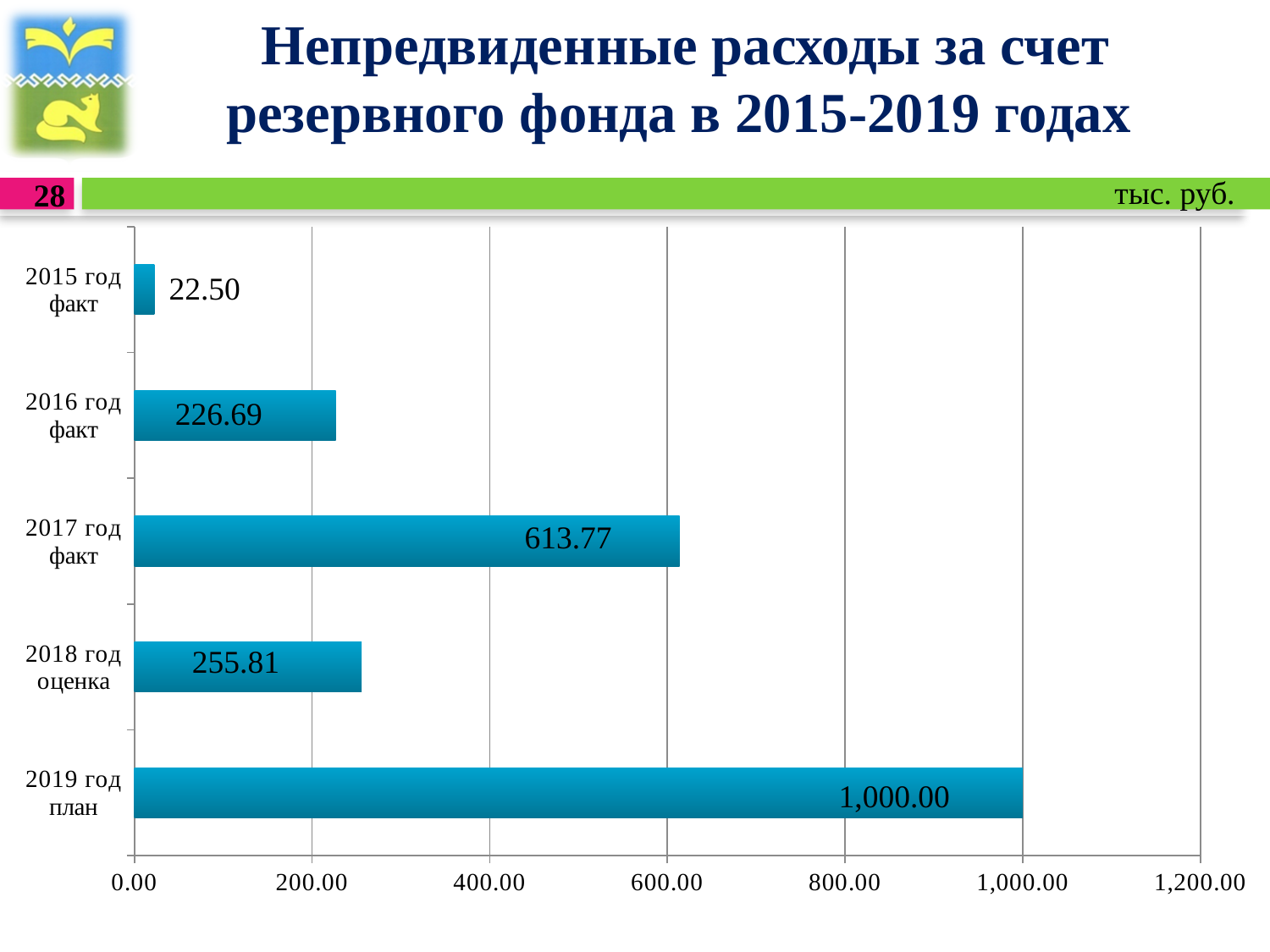
What unit is indicated for the values in the chart? тыс. руб. What is the value for 2017 год факт? 613.77 Which is larger, the value for 2018 год оценка or the value for 2016 год факт? 2018 год оценка Which category has the highest value? 2019 год план What is the value for 2018 год оценка? 255.81 Which category has the lowest value? 2015 год факт What is the value for 2019 год план? 1,000.00 What is the difference between the values for 2017 год факт and 2016 год факт? 387.08 What kind of chart is shown on the slide? bar chart How many categories are shown in the chart? 5 Is the value for 2017 год факт greater or less than 600.00? greater What is the value for 2015 год факт? 22.50